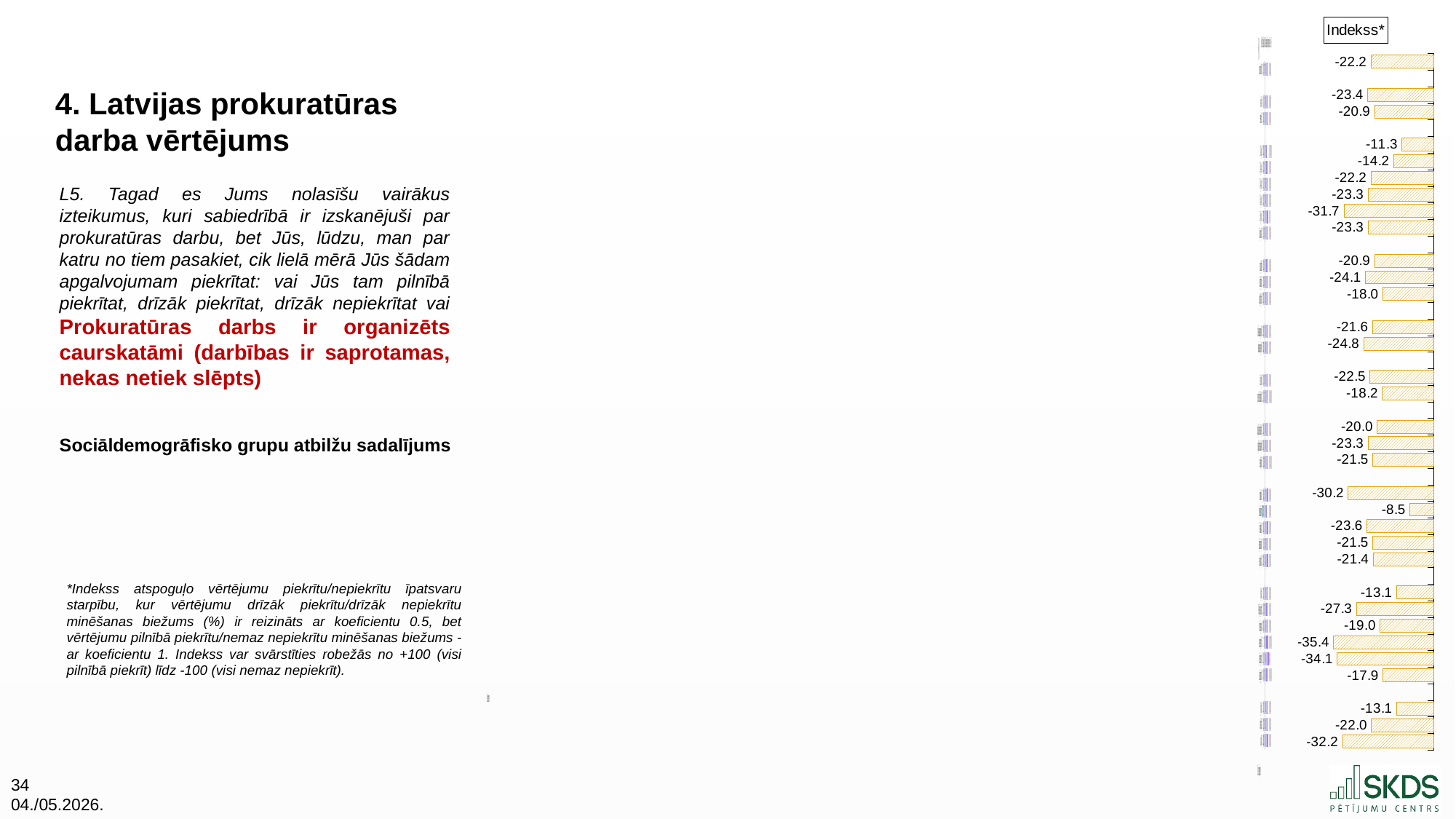
In the "Indekss*" bar chart, what is the difference between the highest value (-8.5) and the lowest value (-35.4)? 26.9 In the "Indekss*" bar chart, which is larger: the topmost bar's value (-22.2) or the bottommost bar's value (-32.2)? -22.2 In the "Indekss*" bar chart, what is the value of the bottommost bar? -32.2 How many bars are plotted in the "Indekss*" bar chart? 33 What kind of chart is shown on the right side of the slide under the heading "Indekss*"? bar chart In the "Indekss*" bar chart, is the lowest value greater or less than -30? less In the "Indekss*" bar chart, what is the value of the topmost bar? -22.2 In the "Indekss*" bar chart, what is the lowest (most negative) value shown? -35.4 In the "Indekss*" bar chart, are all the plotted index values negative or positive? negative In the "Indekss*" bar chart, what is the highest (least negative) value shown? -8.5 What is the heading printed above the bar chart on the right of the slide? Indekss*